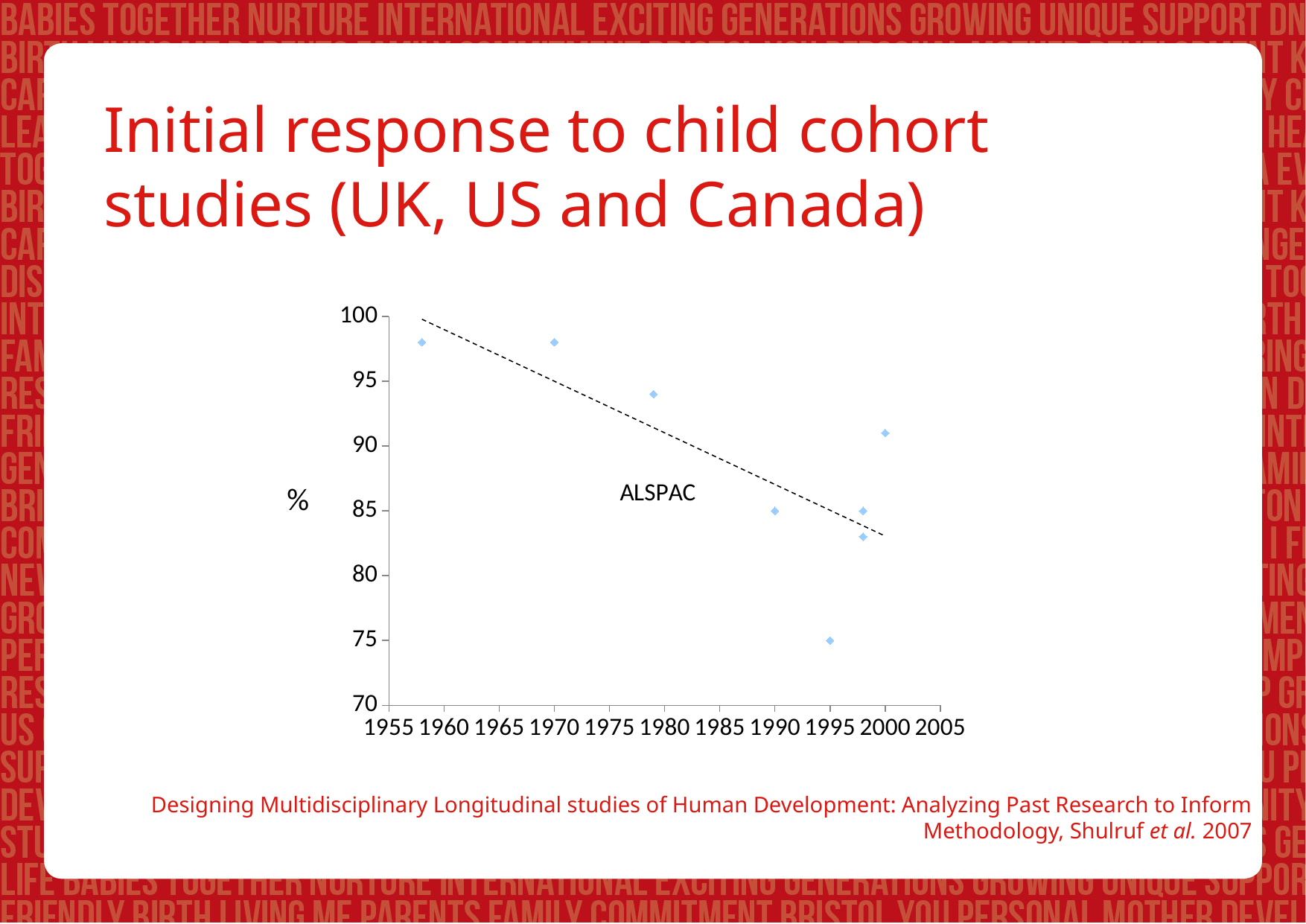
What text label is printed next to the dashed trend line inside the plot area? ALSPAC Do the plotted values generally rise or fall as the year increases along the x axis? fall Is the value for the point near 1980 greater or less than 90? greater What kind of chart is shown on the slide? scatter chart Is the value for the point at 2000 greater or less than 90? greater Which point has the larger value: the one at 1970 or the one at 1990? 1970 What label is printed on the y axis of the chart? % Is the value for the point at 1990 greater or less than 90? less How many data points are plotted on the chart? 8 Which year has the lowest plotted value on the chart? 1995